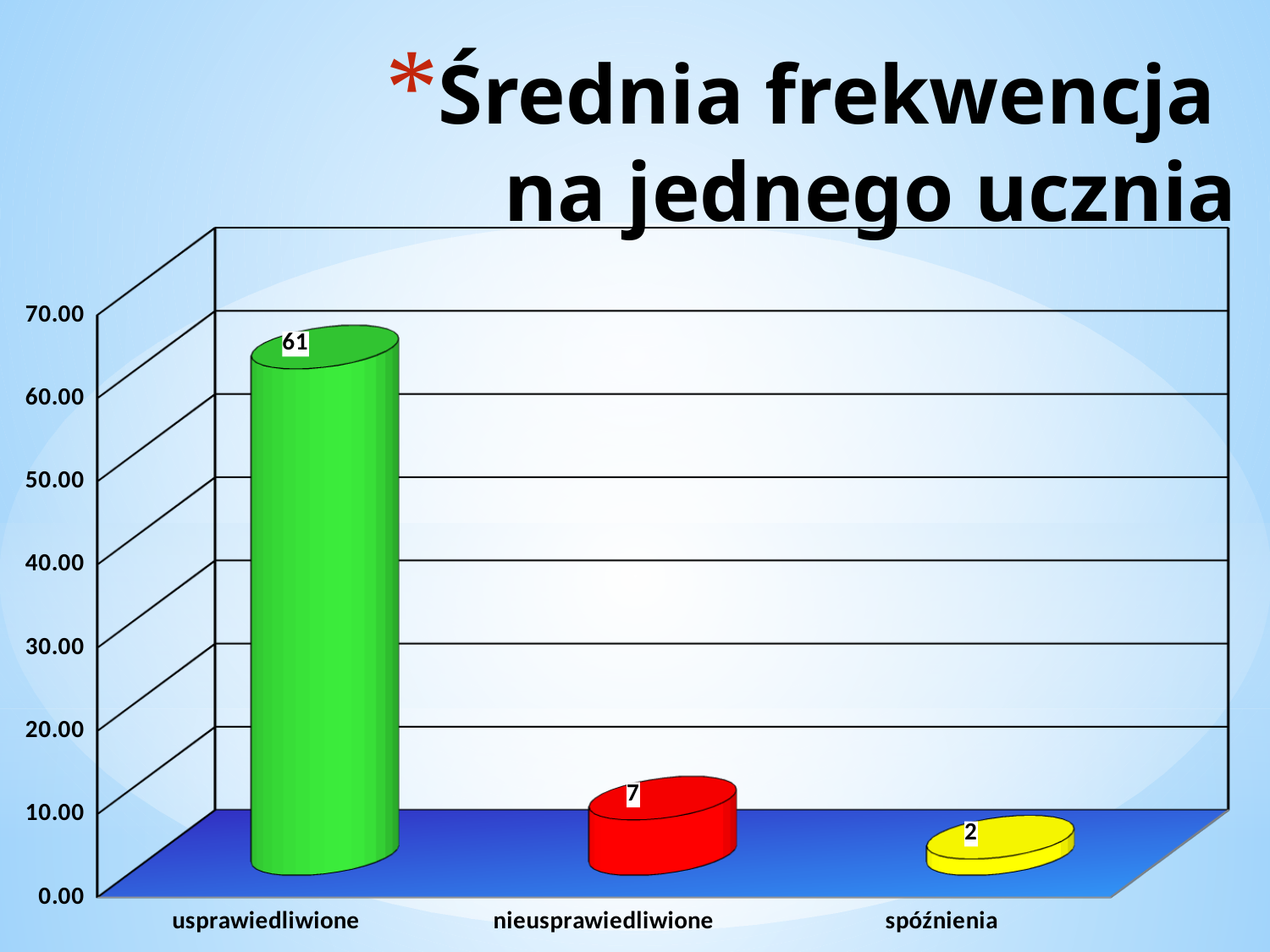
What is the value for nieusprawiedliwione? 7 What is the value for spóźnienia? 2 Is the value for usprawiedliwione greater or less than 50.00? greater What is the difference between the values for usprawiedliwione and nieusprawiedliwione? 54 Which category has the lowest value? spóźnienia What is the value for usprawiedliwione? 61 Which category has the highest value? usprawiedliwione Which is larger, the value for nieusprawiedliwione or the value for spóźnienia? nieusprawiedliwione What kind of chart is shown on the slide? bar chart What is the difference between the values for nieusprawiedliwione and spóźnienia? 5 What is the title of the slide? Średnia frekwencja na jednego ucznia How many categories are shown on the x axis? 3